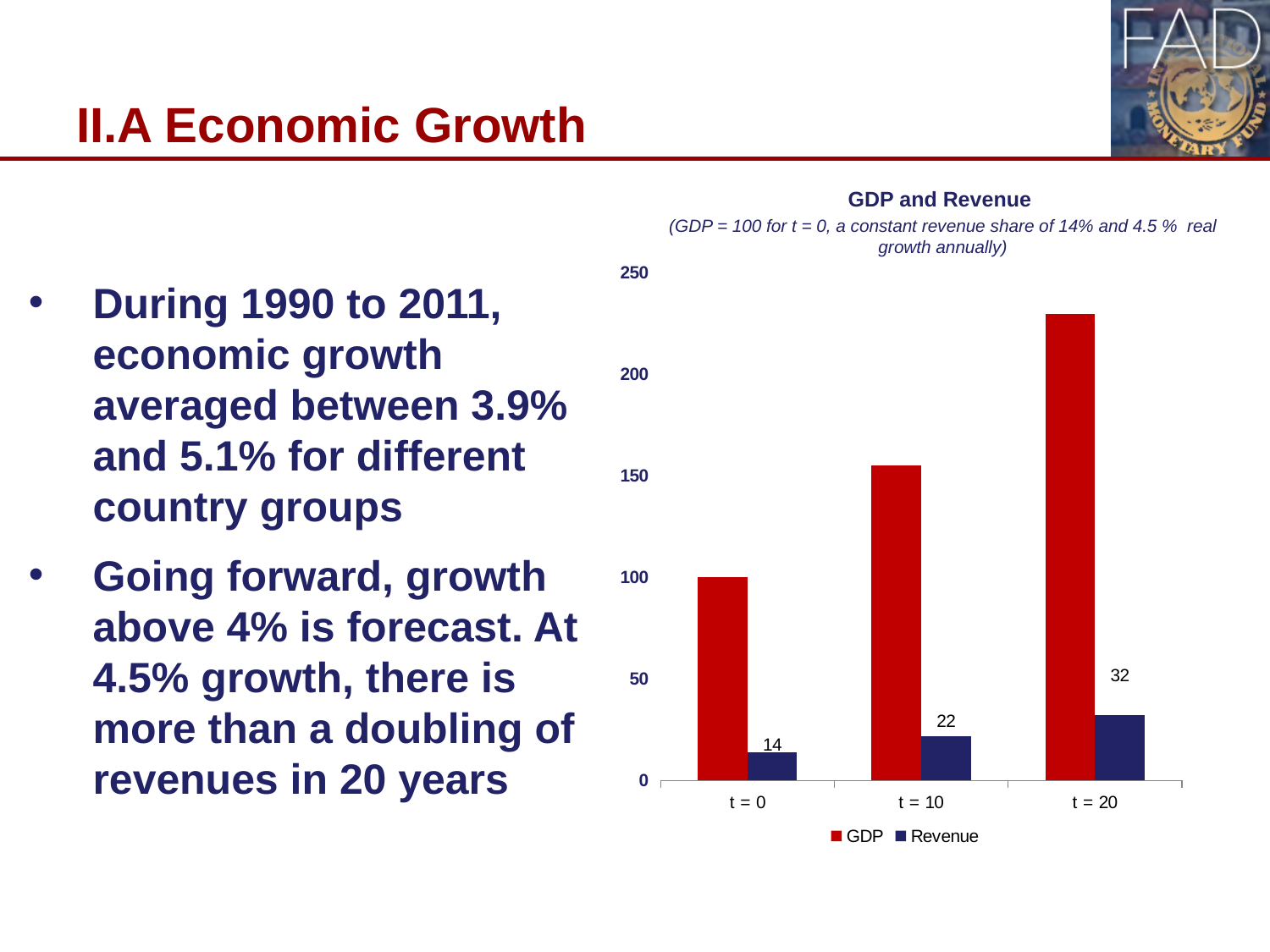
How many series does the legend list? 2 What is the difference between the Revenue values at t = 20 and t = 0? 18 Is the GDP value at t = 20 greater or less than 200? greater What type of chart is shown on the slide? bar chart What is the GDP value at t = 0? 100 What is the Revenue value at t = 0? 14 What is the Revenue value at t = 20? 32 How many categories are shown on the x axis? 3 What is the Revenue value at t = 10? 22 Is the GDP value at t = 10 greater or less than 150? greater Do the Revenue values rise or fall from t = 0 to t = 20? rise What is the title of the chart? GDP and Revenue